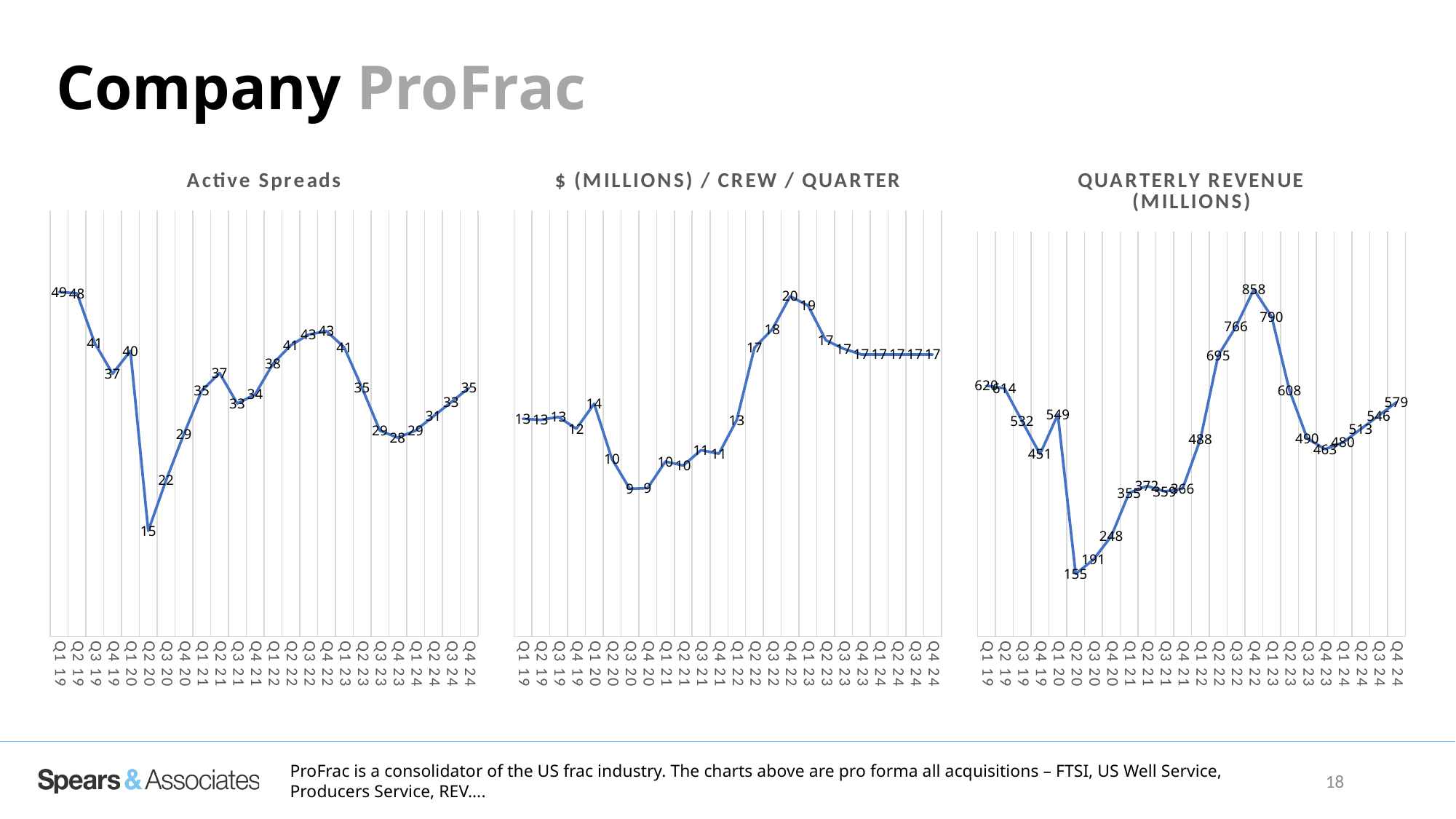
How many quarters are plotted in the Active Spreads chart? 24 In the Active Spreads chart, what is the difference between the Q1 19 value and the Q2 20 value? 34 In the Quarterly Revenue (Millions) chart, which quarter has the lowest value? Q2 20 In the Quarterly Revenue (Millions) chart, do the values rise or fall from Q4 23 to Q4 24? rise What kind of chart is the Quarterly Revenue (Millions) chart? line chart In the $ (MILLIONS) / CREW / QUARTER chart, what is the value for Q4 22? 20 In the $ (MILLIONS) / CREW / QUARTER chart, which is larger, the value for Q1 20 or the value for Q3 20? Q1 20 In the Quarterly Revenue (Millions) chart, what is the difference between the Q4 22 value and the Q1 23 value? 68 In the $ (MILLIONS) / CREW / QUARTER chart, what is the value for Q4 24? 17 In the Active Spreads chart, which quarter has the highest value? Q1 19 In the Quarterly Revenue (Millions) chart, what is the value for Q4 22? 858 In the Active Spreads chart, what is the value for Q2 20? 15